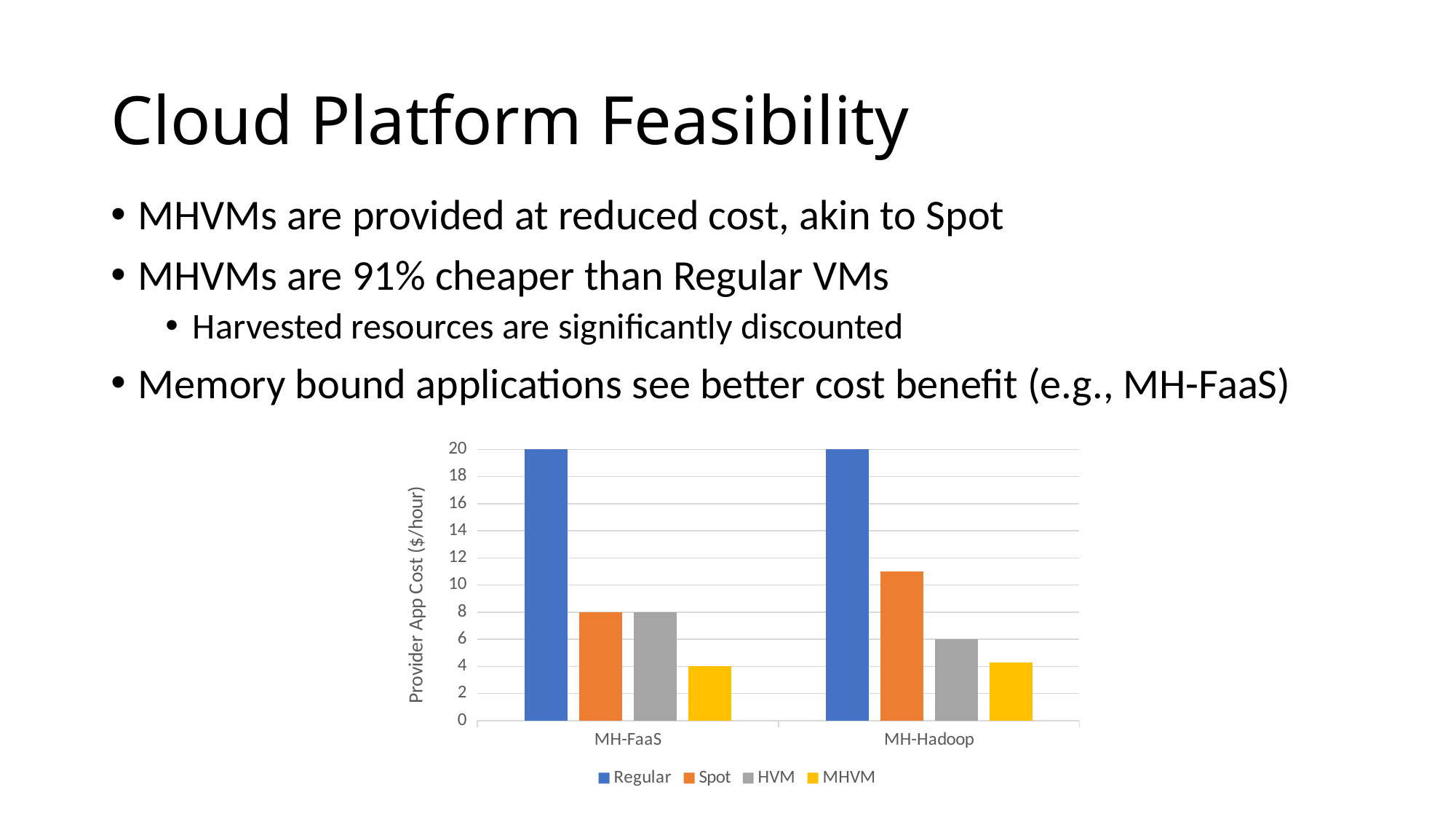
Which series has the lowest cost for MH-FaaS? MHVM Is the Spot cost for MH-Hadoop greater or less than 10? greater What is the Provider App Cost for MHVM for MH-FaaS? 4 How many application categories are shown on the x axis of the chart? 2 What kind of chart is shown on the slide? Bar chart Which series has the highest cost for MH-FaaS? Regular How many series does the chart legend list? 4 What is the Provider App Cost for HVM for MH-Hadoop? 6 What is the label of the chart's vertical axis? Provider App Cost ($/hour) What is the Provider App Cost for Spot for MH-FaaS? 8